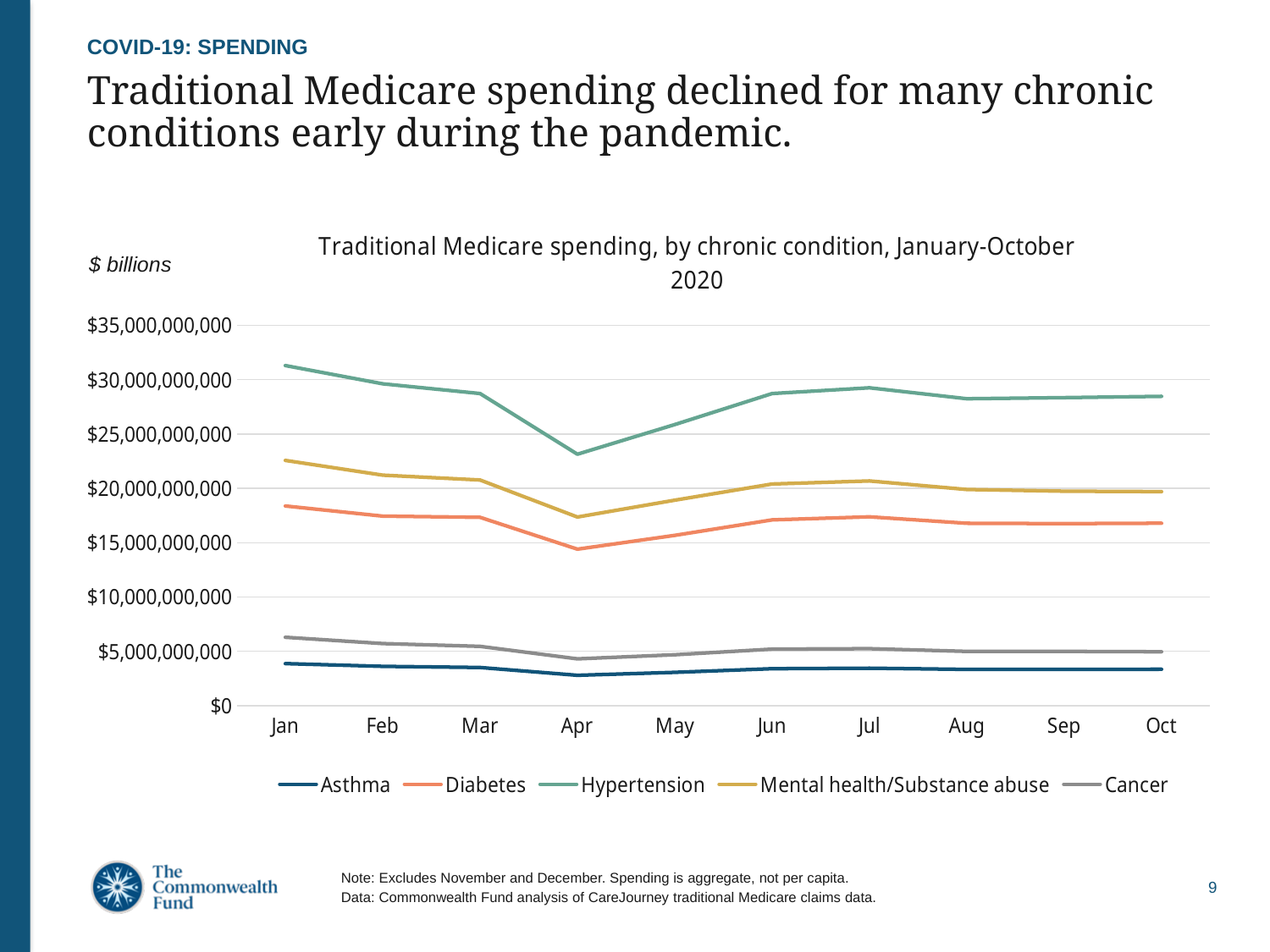
What kind of chart is shown on the slide? line chart How many series does the legend list? 5 Is the value for Cancer in Jan greater or less than $5,000,000,000? greater Is the value for Diabetes in Apr greater or less than $15,000,000,000? less Does Hypertension spending rise or fall from Jan to Apr? fall In which month is Hypertension spending at its lowest? Apr Is the value for Hypertension in Jan greater or less than $30,000,000,000? greater How many months are plotted along the x axis? 10 In Jan, which is larger: spending for Mental health/Substance abuse or for Diabetes? Mental health/Substance abuse Which chronic condition has the highest traditional Medicare spending across the months shown? Hypertension Which chronic condition has the lowest traditional Medicare spending across the months shown? Asthma